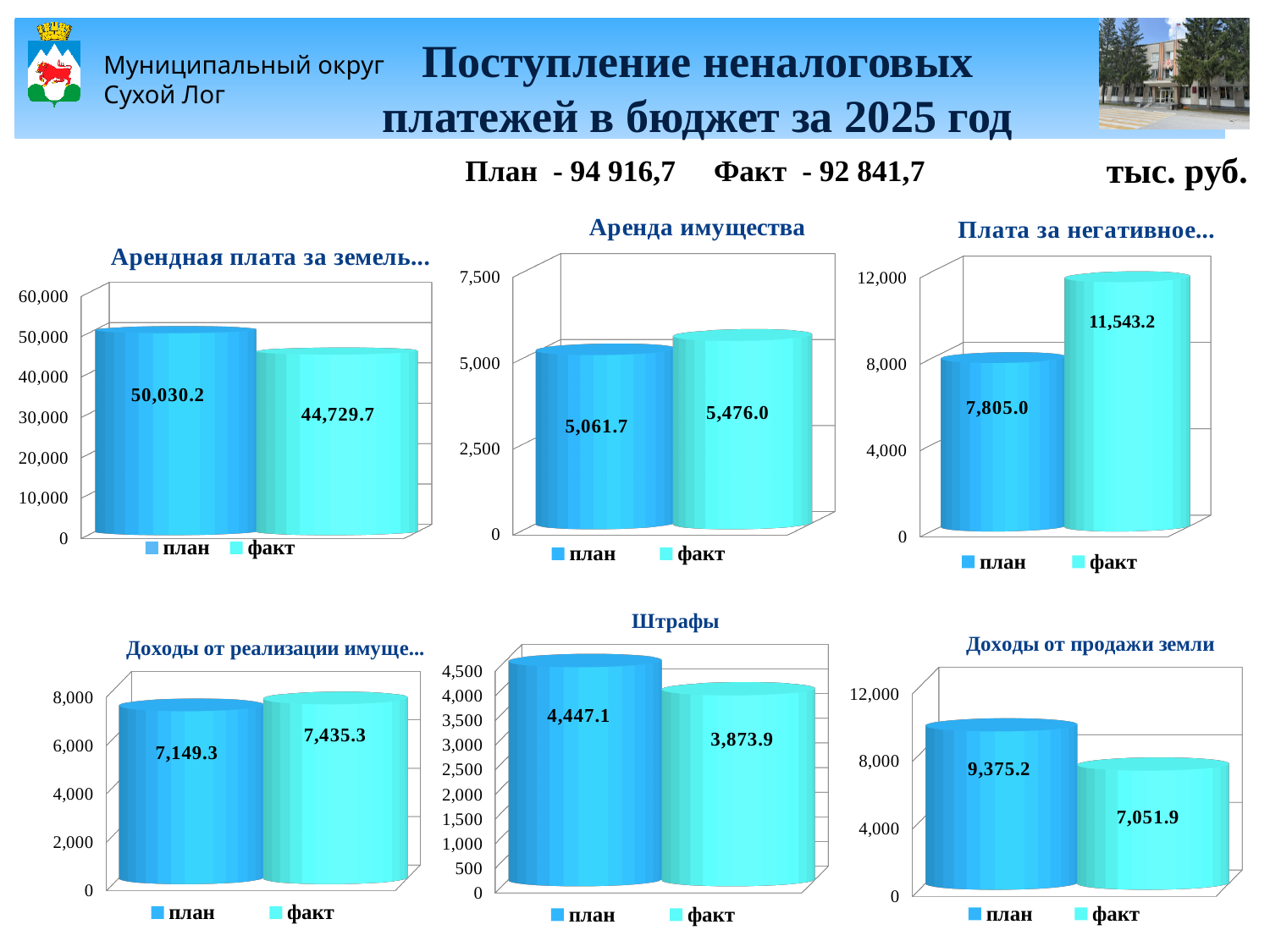
In the top-right chart (Плата за негативное...), what is the difference between факт and план? 3,738.2 In the "Доходы от продажи земли" chart, what is the difference between план and факт? 2,323.3 In the "Аренда имущества" chart, what is the value for план? 5,061.7 How many series does the legend of the "Штрафы" chart list? 2 In the top-left chart (Арендная плата за земель...), what is the value for факт? 44,729.7 In the "Доходы от продажи земли" chart, what is the value for план? 9,375.2 In the "Штрафы" chart, what is the value for факт? 3,873.9 What type of chart is the "Аренда имущества" chart? bar chart In the top-right chart (Плата за негативное...), which series is higher, план or факт? факт In the top-left chart (Арендная плата за земель...), what is the difference between план and факт? 5,300.5 In the bottom-left chart (Доходы от реализации имуще...), is the value for план greater or less than 6,000? greater In the "Штрафы" chart, which series is higher, план or факт? план